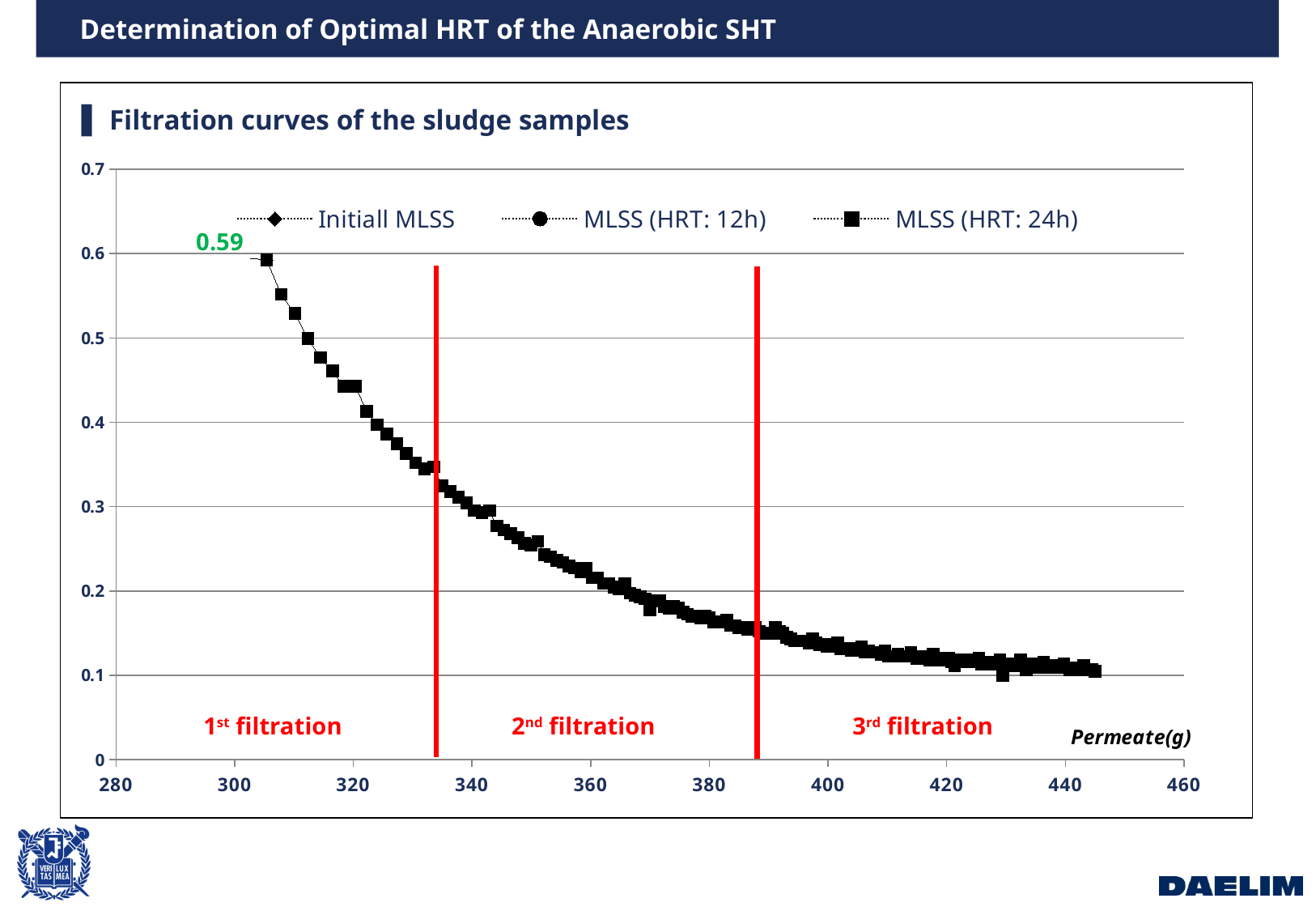
What type of chart is shown on the slide? line chart Is the plotted value at a permeate of 400 g greater or less than 0.2? less What is the title of the chart? Filtration curves of the sludge samples How many series does the legend list? 3 What is the highest plotted value on the chart? 0.59 What is the labelled value at the start of the MLSS (HRT: 24h) curve? 0.59 Which is larger, the plotted value at a permeate of 320 g or at 400 g? 320 g Do the plotted values rise or fall as Permeate(g) increases? fall What is the label of the x axis? Permeate(g) Is the plotted value at a permeate of 360 g greater or less than 0.3? less Is the plotted value at a permeate of 320 g greater or less than 0.4? greater